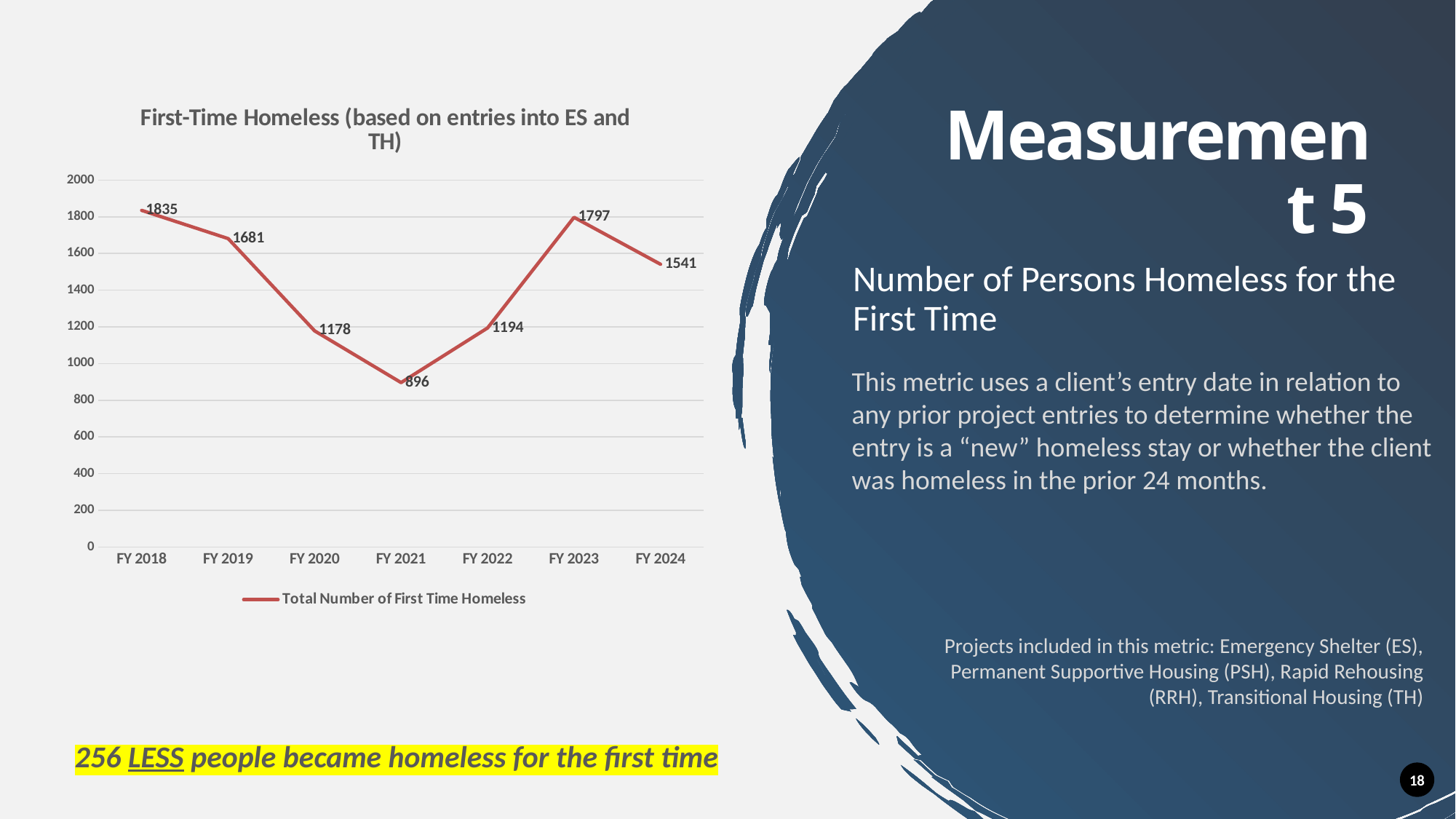
Is the value for FY 2023 greater or less than 1600? greater How many fiscal years are plotted on the chart? 7 Which is larger, the value for FY 2020 or FY 2022? FY 2022 What is the difference between the values for FY 2019 and FY 2020? 503 Which fiscal year has the lowest value? FY 2021 What is the value for FY 2021? 896 What is the value for FY 2024? 1541 Which fiscal year has the highest value? FY 2018 What is the value for FY 2018? 1835 What kind of chart is shown on the slide? Line chart What is the legend entry for the plotted series? Total Number of First Time Homeless What is the difference between the values for FY 2023 and FY 2024? 256